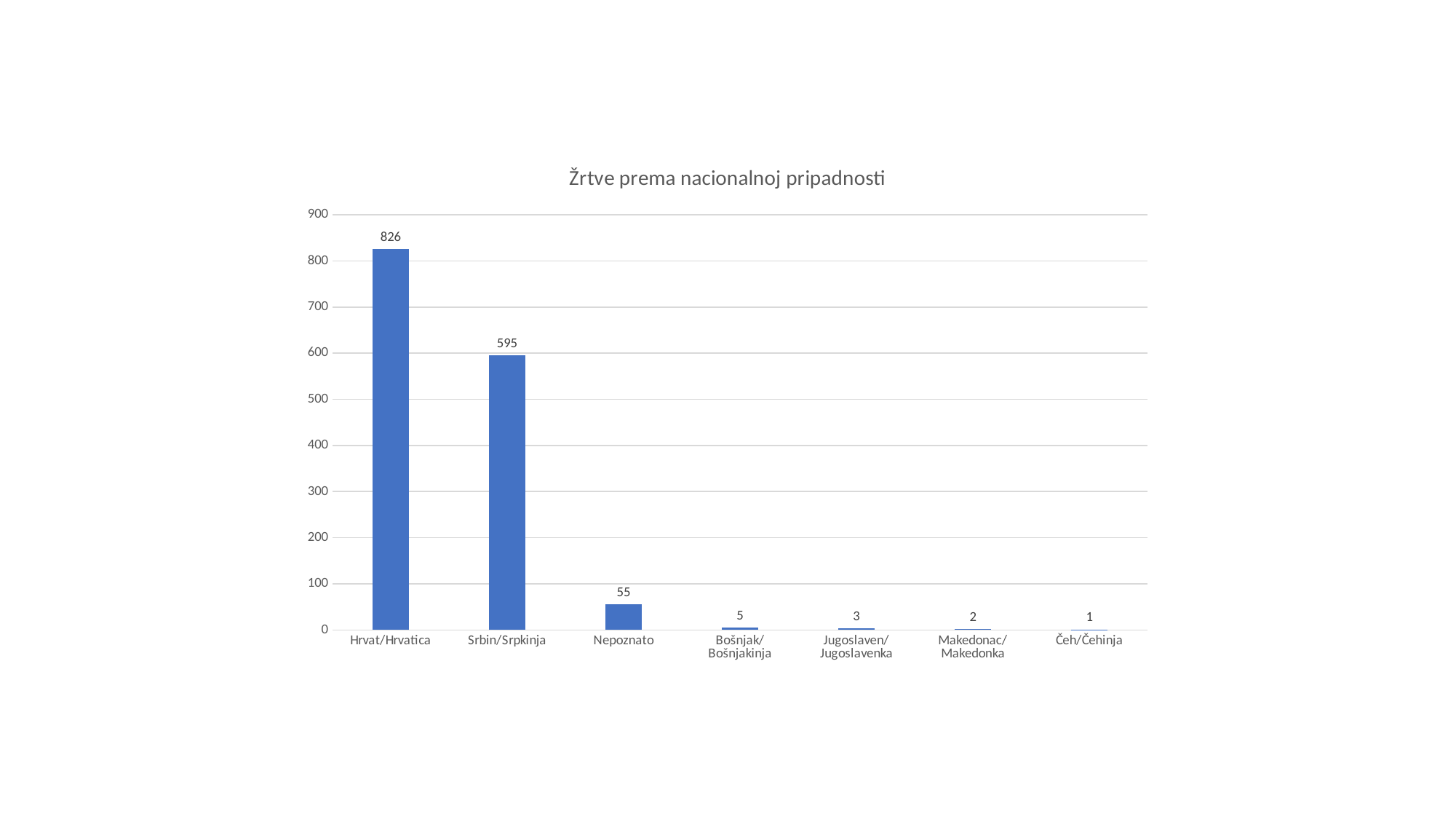
What is the value for Hrvat/Hrvatica? 826 Which is larger, the value for Nepoznato or the value for Bošnjak/Bošnjakinja? Nepoznato What kind of chart is shown on the slide? bar chart What is the value for Nepoznato? 55 Which category has the lowest value? Čeh/Čehinja How many categories are shown on the x axis? 7 What is the title of the chart? Žrtve prema nacionalnoj pripadnosti What is the value for Jugoslaven/Jugoslavenka? 3 Which category has the highest value? Hrvat/Hrvatica Is the value for Srbin/Srpkinja greater or less than 500? greater What is the difference between the values for Hrvat/Hrvatica and Srbin/Srpkinja? 231 What is the value for Srbin/Srpkinja? 595